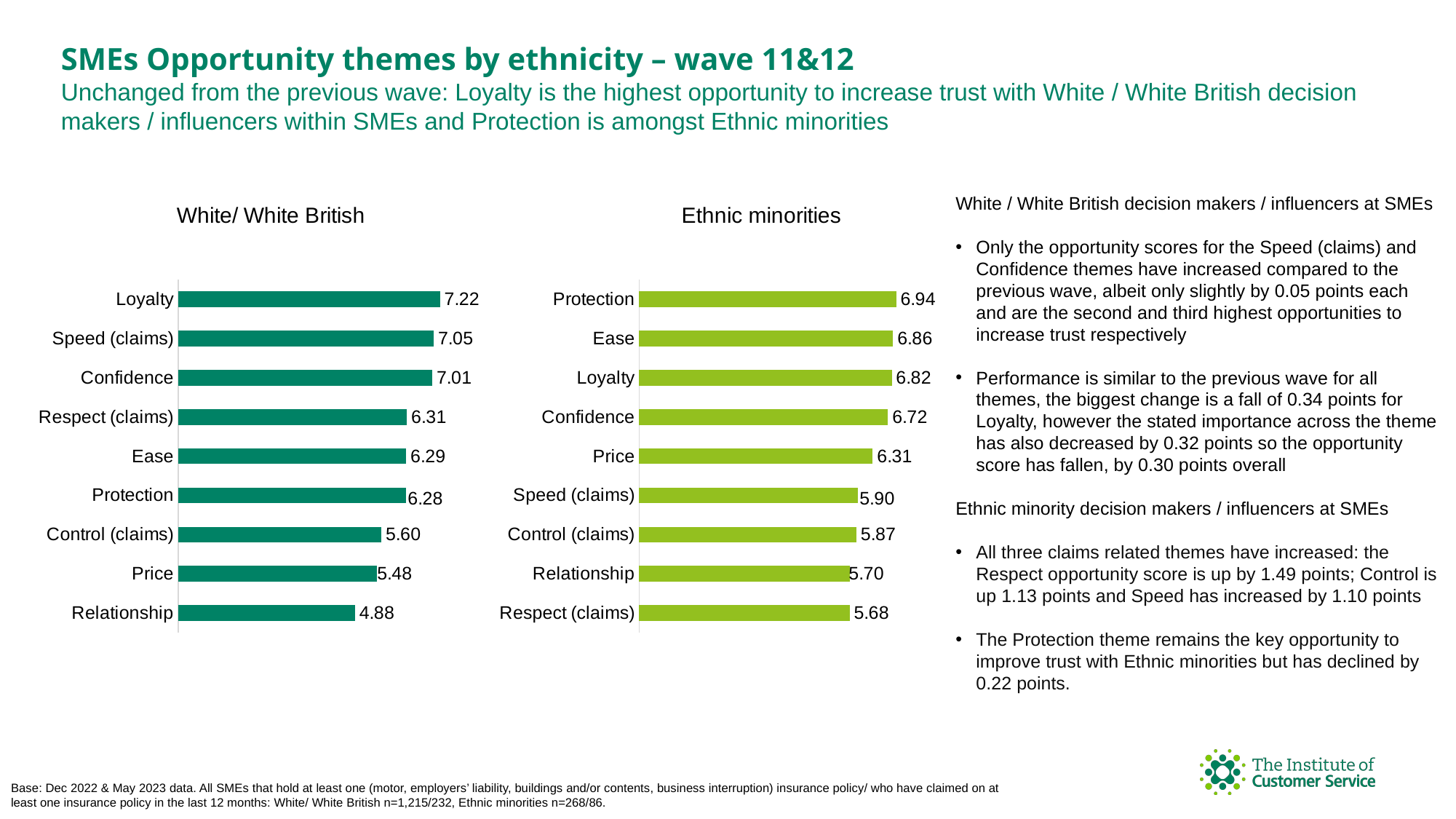
In the 'White/ White British' chart, which category has the lowest value? Relationship In the 'Ethnic minorities' chart, what is the difference between Protection and Price? 0.63 In the 'White/ White British' chart, which is larger: Speed (claims) or Control (claims)? Speed (claims) In the 'Ethnic minorities' chart, what is the value for Protection? 6.94 How many categories are shown in the 'Ethnic minorities' chart? 9 In the 'White/ White British' chart, what is the value for Control (claims)? 5.60 In the 'Ethnic minorities' chart, which category has the lowest value? Respect (claims) In the 'White/ White British' chart, what is the value for Loyalty? 7.22 What type of chart is the 'White/ White British' chart? Bar chart In the 'White/ White British' chart, what is the difference between Loyalty and Relationship? 2.34 In the 'Ethnic minorities' chart, which category has the highest value? Protection Which is larger: Price in the 'White/ White British' chart or Price in the 'Ethnic minorities' chart? Ethnic minorities